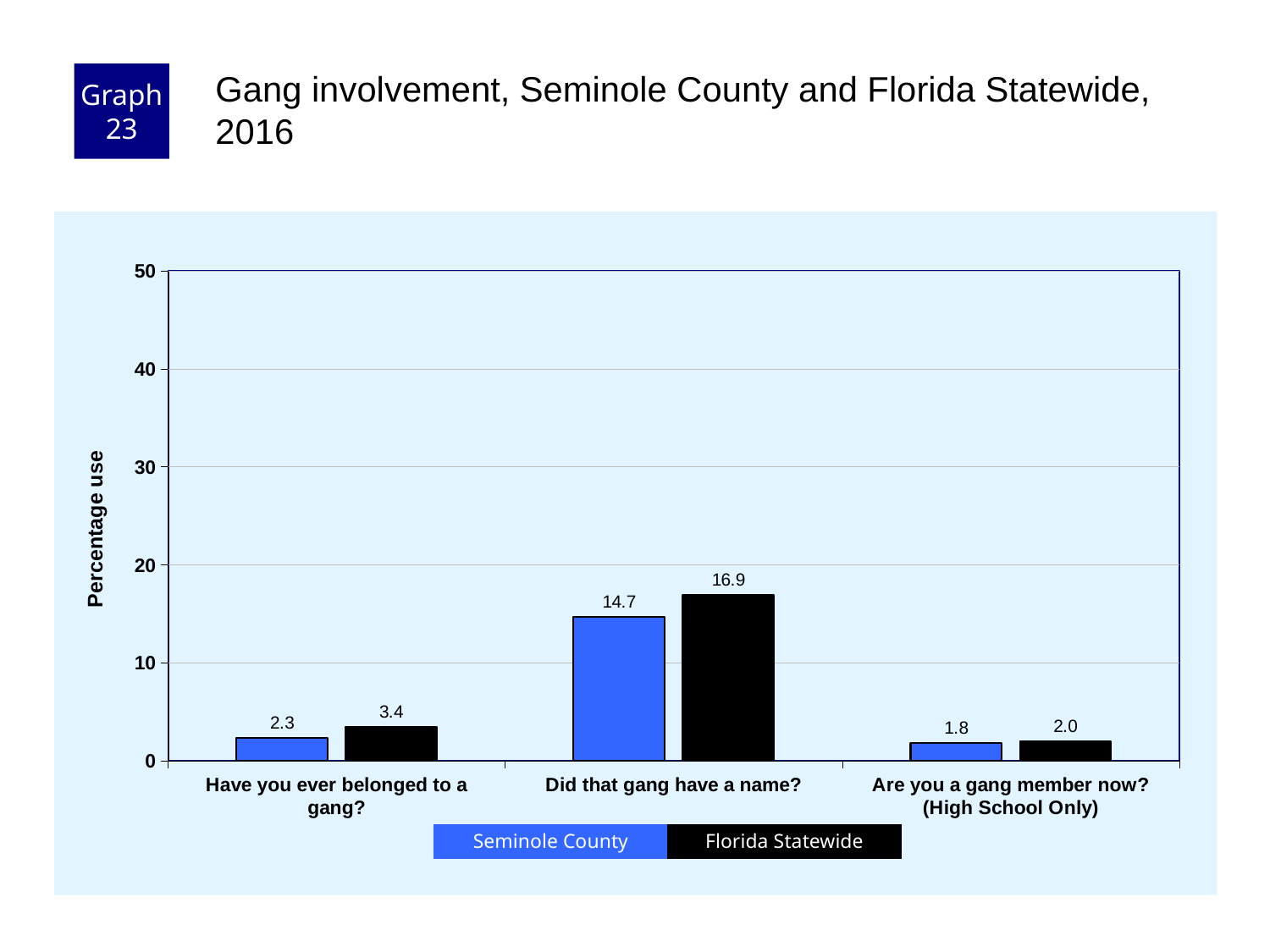
What is the Seminole County value for "Have you ever belonged to a gang?"? 2.3 For "Have you ever belonged to a gang?", which is larger: Seminole County or Florida Statewide? Florida Statewide Is the Florida Statewide value for "Did that gang have a name?" greater or less than 20? less What is the Florida Statewide value for "Did that gang have a name?"? 16.9 What is the Florida Statewide value for "Have you ever belonged to a gang?"? 3.4 How many question categories are shown on the x axis? 3 What is the difference between the Florida Statewide and Seminole County values for "Did that gang have a name?"? 2.2 How many series does the legend list? 2 Which question has the highest Seminole County value? Did that gang have a name? Which question has the lowest Florida Statewide value? Are you a gang member now? (High School Only) What is the Seminole County value for "Are you a gang member now? (High School Only)"? 1.8 What kind of chart is shown on the slide? bar chart